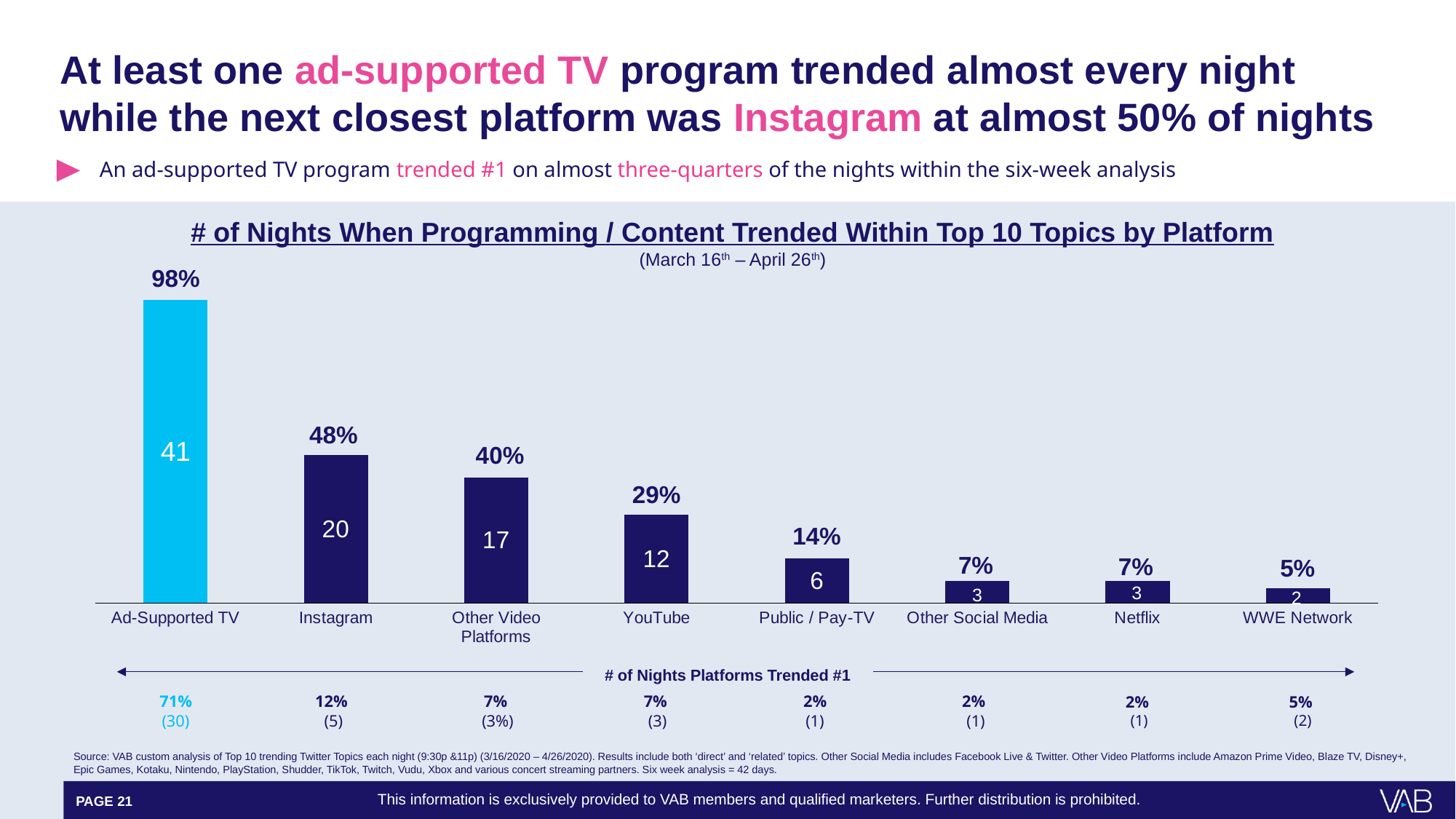
Which has more nights, Other Video Platforms or YouTube? Other Video Platforms What percentage is shown above the YouTube bar? 29% What is the number of nights shown for Instagram? 20 How many platforms are shown on the x axis of the chart? 8 What is the difference in number of nights between Ad-Supported TV and Instagram? 21 Which platform has the lowest number of nights in the chart? WWE Network What percentage is shown above the Netflix bar? 7% Which platform has the highest number of nights in the chart? Ad-Supported TV What is the number of nights shown for Public / Pay-TV? 6 What kind of chart is shown on the slide? Bar chart Do the values rise or fall moving from left to right along the x axis? Fall What is the title of the chart? # of Nights When Programming / Content Trended Within Top 10 Topics by Platform